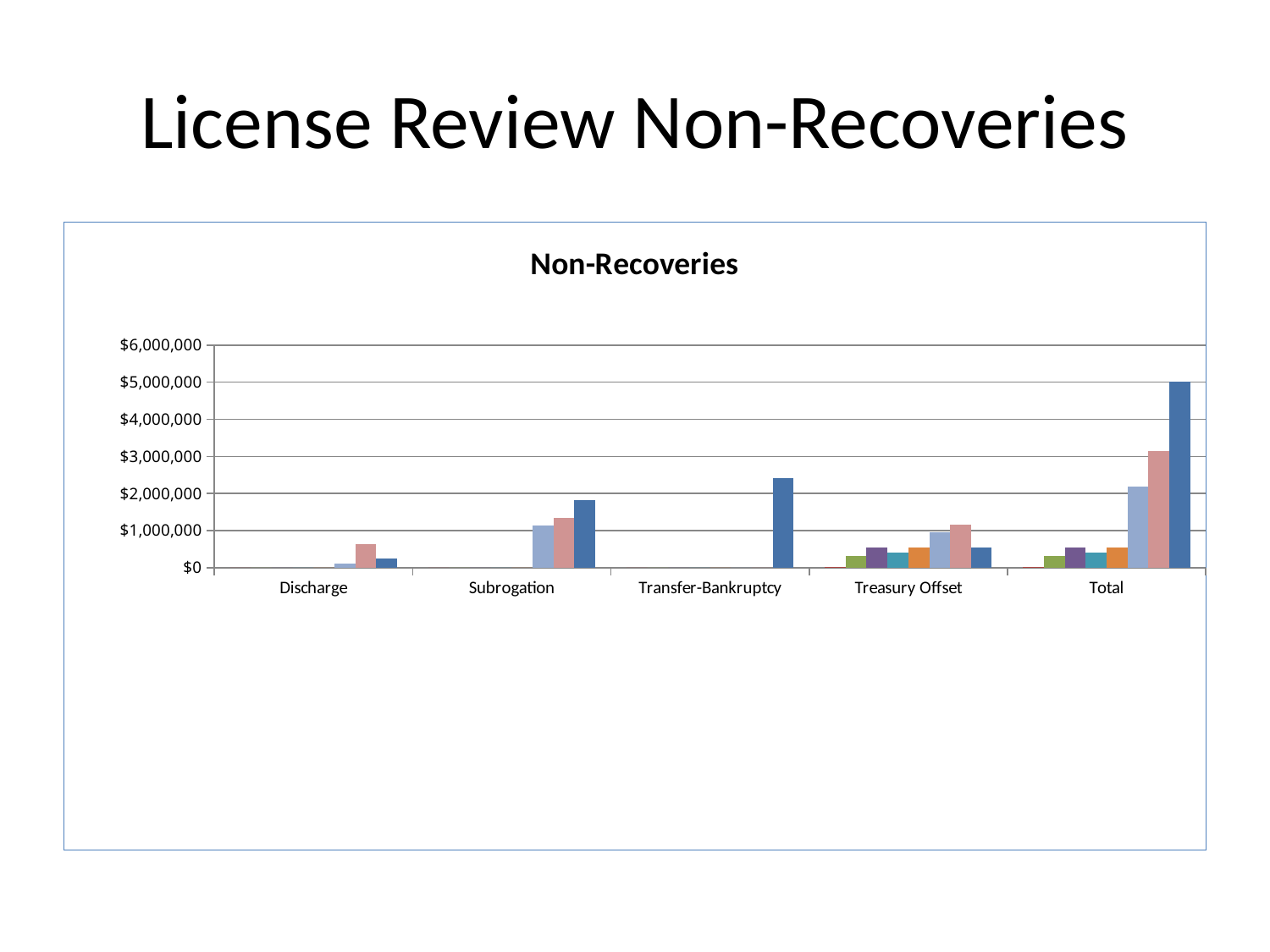
Is the tallest bar for Transfer-Bankruptcy greater or less than $2,000,000? greater What kind of chart is shown on the slide? bar chart Is the tallest bar for Discharge greater or less than $1,000,000? less Is the tallest bar for Treasury Offset greater or less than $2,000,000? less What is the title of the chart on the slide? Non-Recoveries Which is larger: the tallest bar for Discharge or the tallest bar for Treasury Offset? Treasury Offset Which is larger: the tallest bar for Subrogation or the tallest bar for Transfer-Bankruptcy? Transfer-Bankruptcy How many categories are shown on the x axis of the Non-Recoveries chart? 5 Which category on the Non-Recoveries chart contains the tallest bar? Total What is the highest value shown on the y axis of the Non-Recoveries chart? $6,000,000